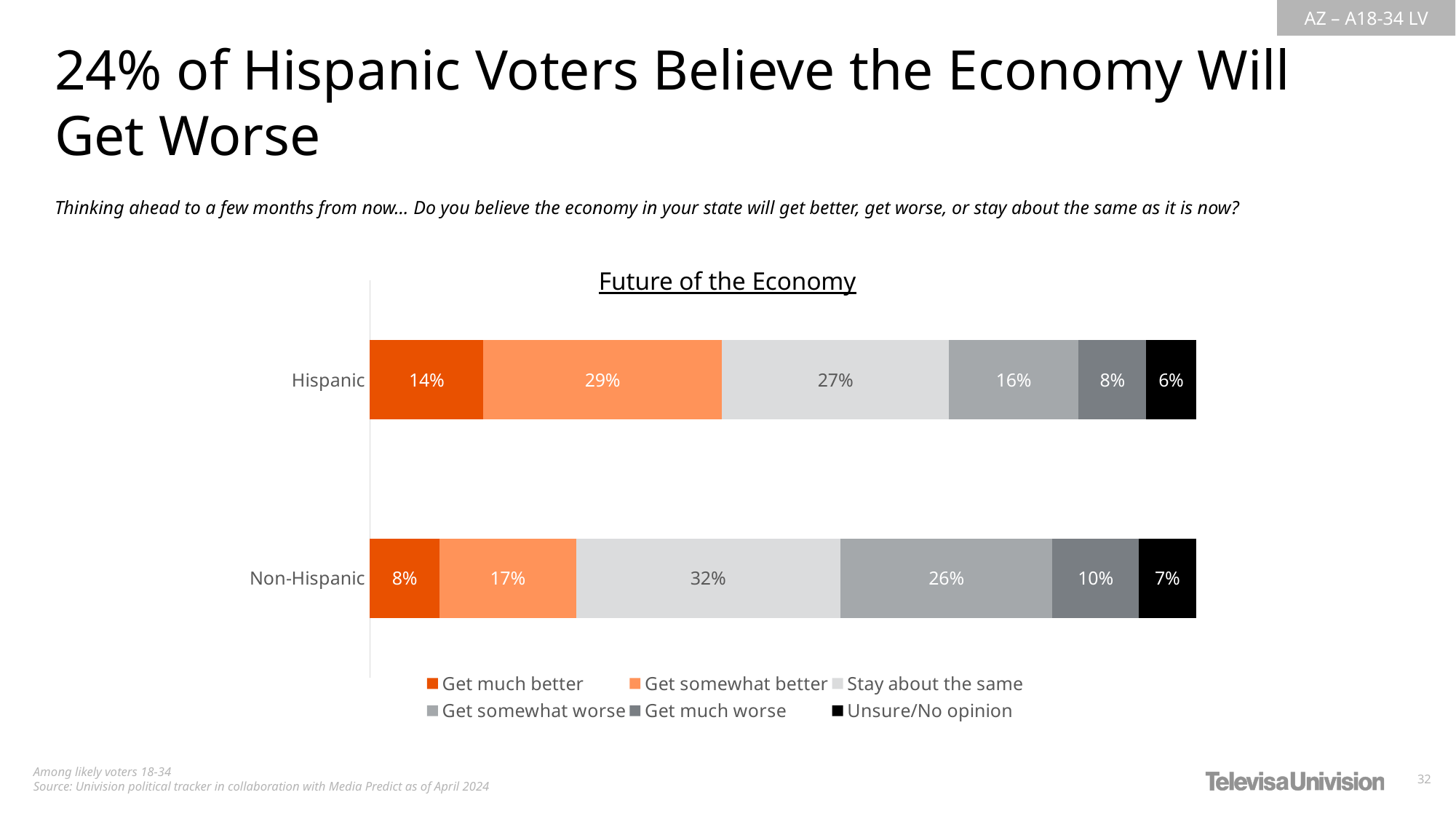
What is the combined percentage of Hispanic voters who say the economy will get somewhat worse or much worse? 24% How many groups (bars) are shown in the chart? 2 What percentage of Non-Hispanic voters say the economy will stay about the same? 32% What percentage of Hispanic voters say the economy will get somewhat better? 29% Which response category has the largest share among Non-Hispanic voters? Stay about the same Which response category has the smallest share among Hispanic voters? Unsure/No opinion Which group has a higher percentage saying the economy will get somewhat worse, Hispanic or Non-Hispanic? Non-Hispanic How many series does the legend list? 6 What is the difference between the Hispanic and Non-Hispanic percentages for 'Get somewhat better'? 12 percentage points What type of chart is shown on the slide? Stacked bar chart What percentage of Non-Hispanic voters say the economy will get much worse? 10% What percentage of Hispanic voters are unsure or have no opinion? 6%